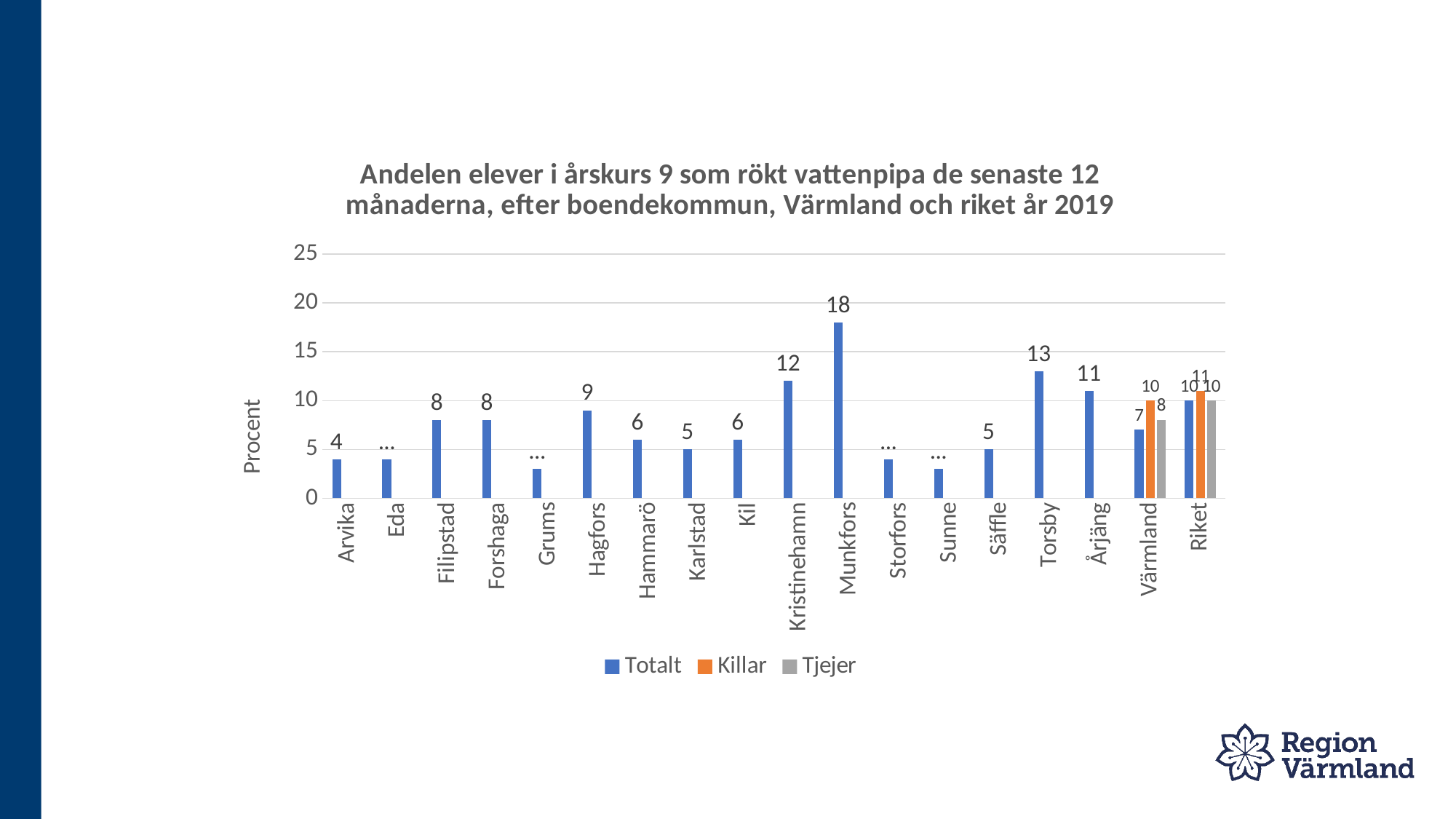
Is the Totalt value for Munkfors greater or less than 15? greater What is the label on the y axis? Procent Which municipality has the highest Totalt value? Munkfors How many categories are shown on the x axis? 18 What is the difference between the Totalt values for Munkfors and Kristinehamn? 6 Which has the larger Totalt value, Torsby or Ärjäng? Torsby How many series does the legend list? 3 What is the Killar value for Värmland? 10 What kind of chart is shown on the slide? bar chart What is the Tjejer value for Riket? 10 What is the Totalt value for Munkfors? 18 What is the Totalt value for Torsby? 13